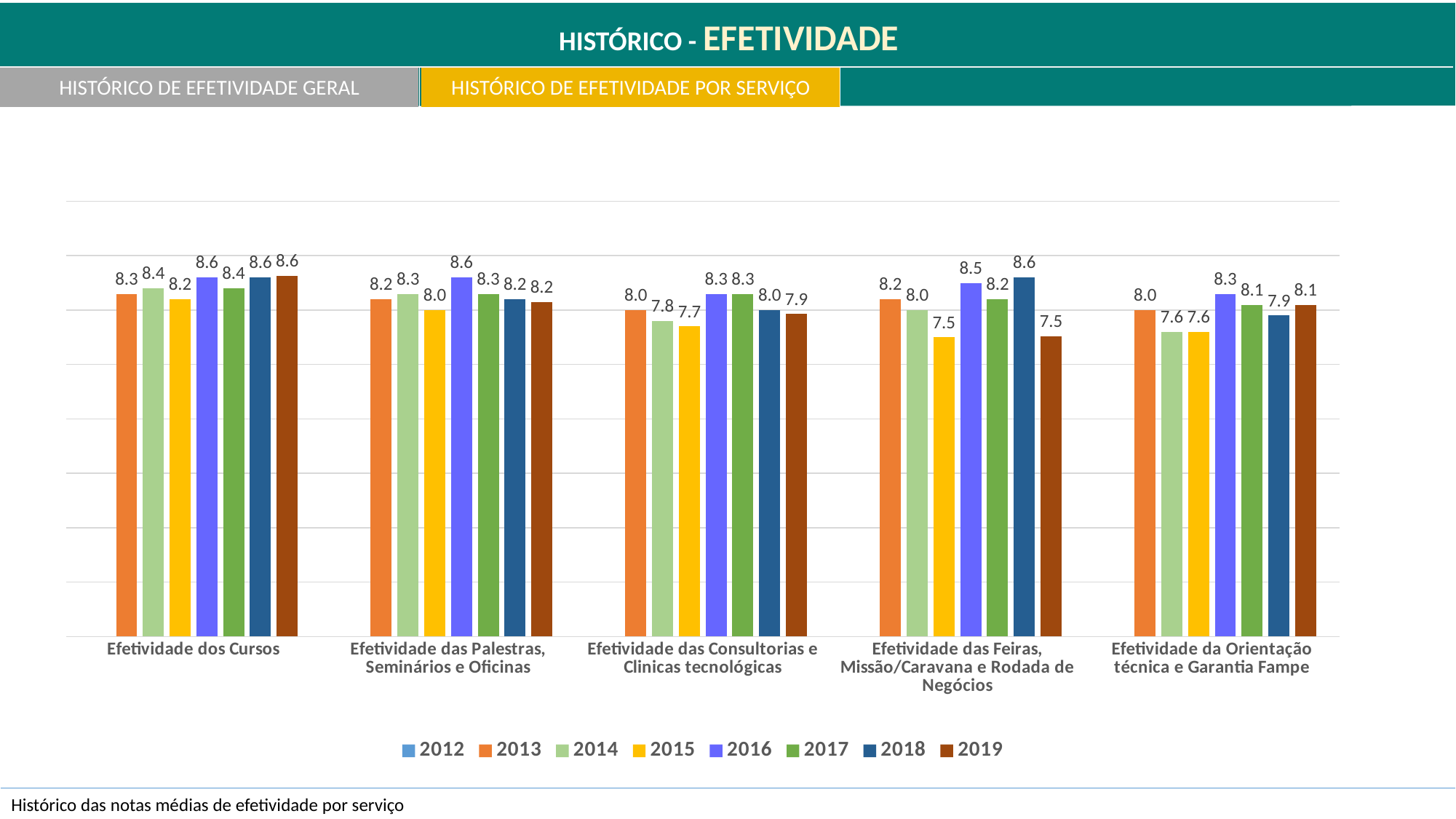
What is the value for 2019 in the 'Efetividade da Orientação técnica e Garantia Fampe' category? 8.1 Which is larger in the 'Efetividade da Orientação técnica e Garantia Fampe' category: the 2016 value or the 2018 value? 2016 How many service categories are shown on the x axis? 5 Which year has the highest value in the 'Efetividade das Feiras, Missão/Caravana e Rodada de Negócios' category? 2018 What kind of chart is shown on the slide? bar chart What is the value for 2016 in the 'Efetividade das Palestras, Seminários e Oficinas' category? 8.6 What is the difference between the 2018 and 2019 values in the 'Efetividade das Feiras, Missão/Caravana e Rodada de Negócios' category? 1.1 What is the title shown at the top of the slide? HISTÓRICO - EFETIVIDADE Which year has the lowest value in the 'Efetividade das Consultorias e Clinicas tecnológicas' category? 2015 What is the value for 2015 in the 'Efetividade das Feiras, Missão/Caravana e Rodada de Negócios' category? 7.5 How many series does the legend list? 8 What is the difference between the 2014 and 2015 values in the 'Efetividade das Palestras, Seminários e Oficinas' category? 0.3